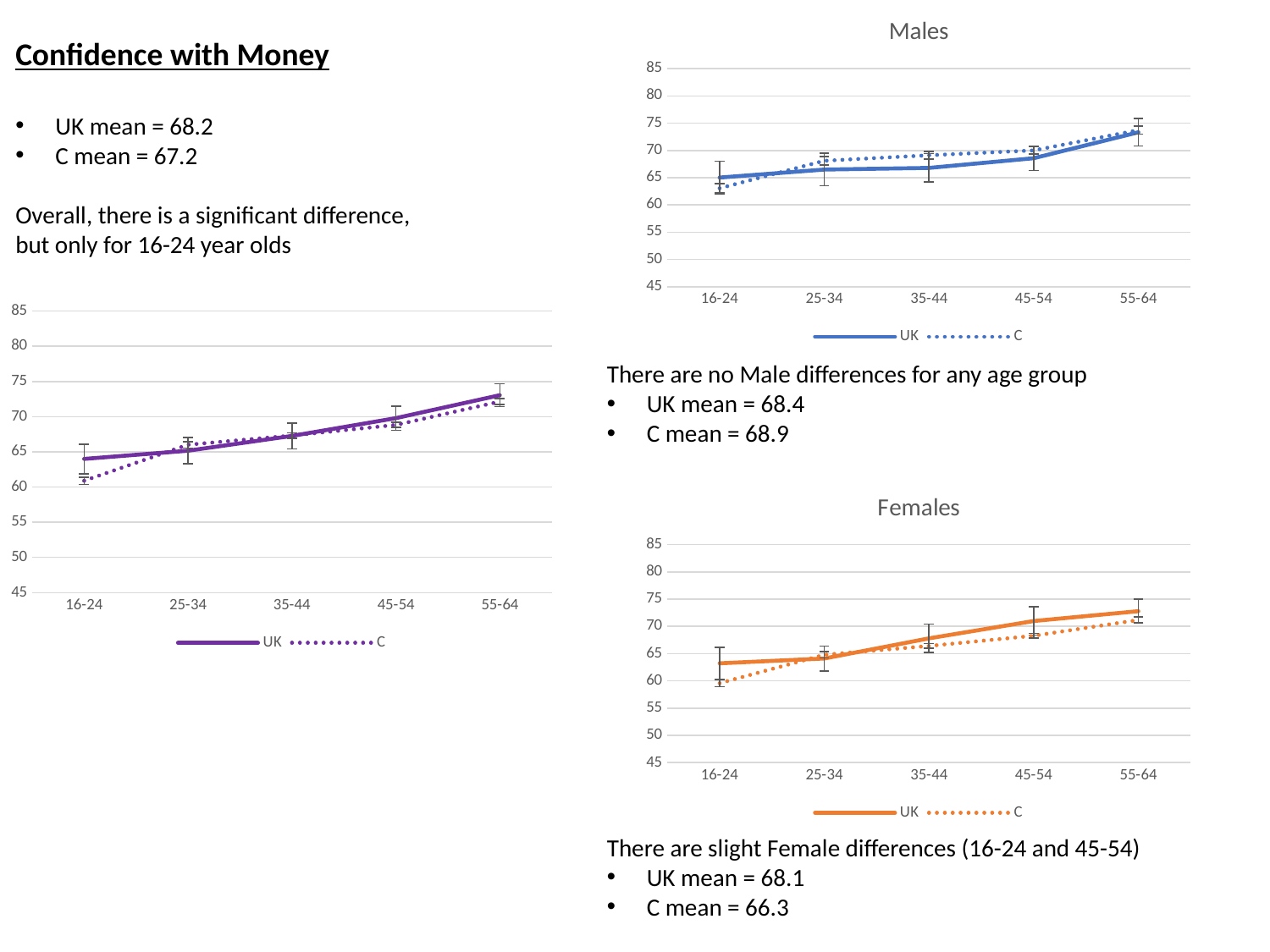
What is the title of the chart at the top right of the slide? Males In the Males chart, which series has the larger value for 25-34, UK or C? C In the Females chart, which series has the larger value for 16-24, UK or C? UK In the Males chart, is the UK value for 55-64 greater or less than 70? greater In the Females chart, is the C value for 16-24 greater or less than 65? less In the chart on the left of the slide, is the C value for 16-24 greater or less than 65? less In the chart on the left of the slide, which age group has the highest value for the UK series? 55-64 How many series does the legend of the Males chart list? 2 In the Females chart, do the UK values rise or fall from 16-24 to 55-64? rise How many age groups are shown on the x axis of the Females chart? 5 In the Females chart, which age group has the lowest value for the C series? 16-24 What kind of chart is the Males chart? line chart